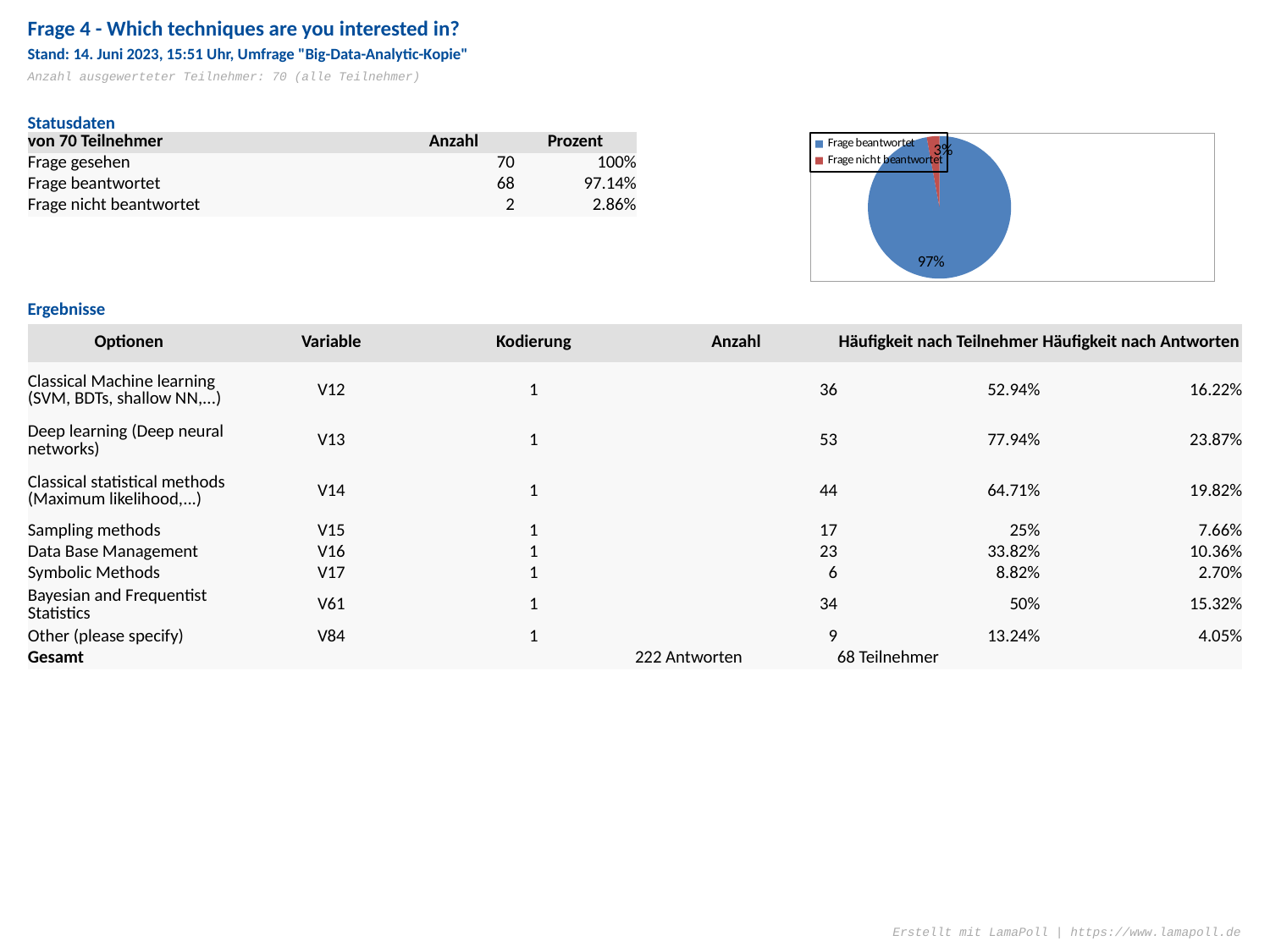
Which slice of the pie chart is the smallest? Frage nicht beantwortet Which is larger in the pie chart, "Frage beantwortet" or "Frage nicht beantwortet"? Frage beantwortet What kind of chart is shown on the slide? pie chart How many entries does the pie chart's legend list? 2 What share of the pie does "Frage nicht beantwortet" represent? 3% What colour is the "Frage nicht beantwortet" slice in the pie chart? red What colour is the "Frage beantwortet" slice in the pie chart? blue What share of the pie does "Frage beantwortet" represent? 97% Which slice of the pie chart is the largest? Frage beantwortet How many slices does the pie chart have? 2 What is the difference in percentage points between the "Frage beantwortet" and "Frage nicht beantwortet" slices? 94